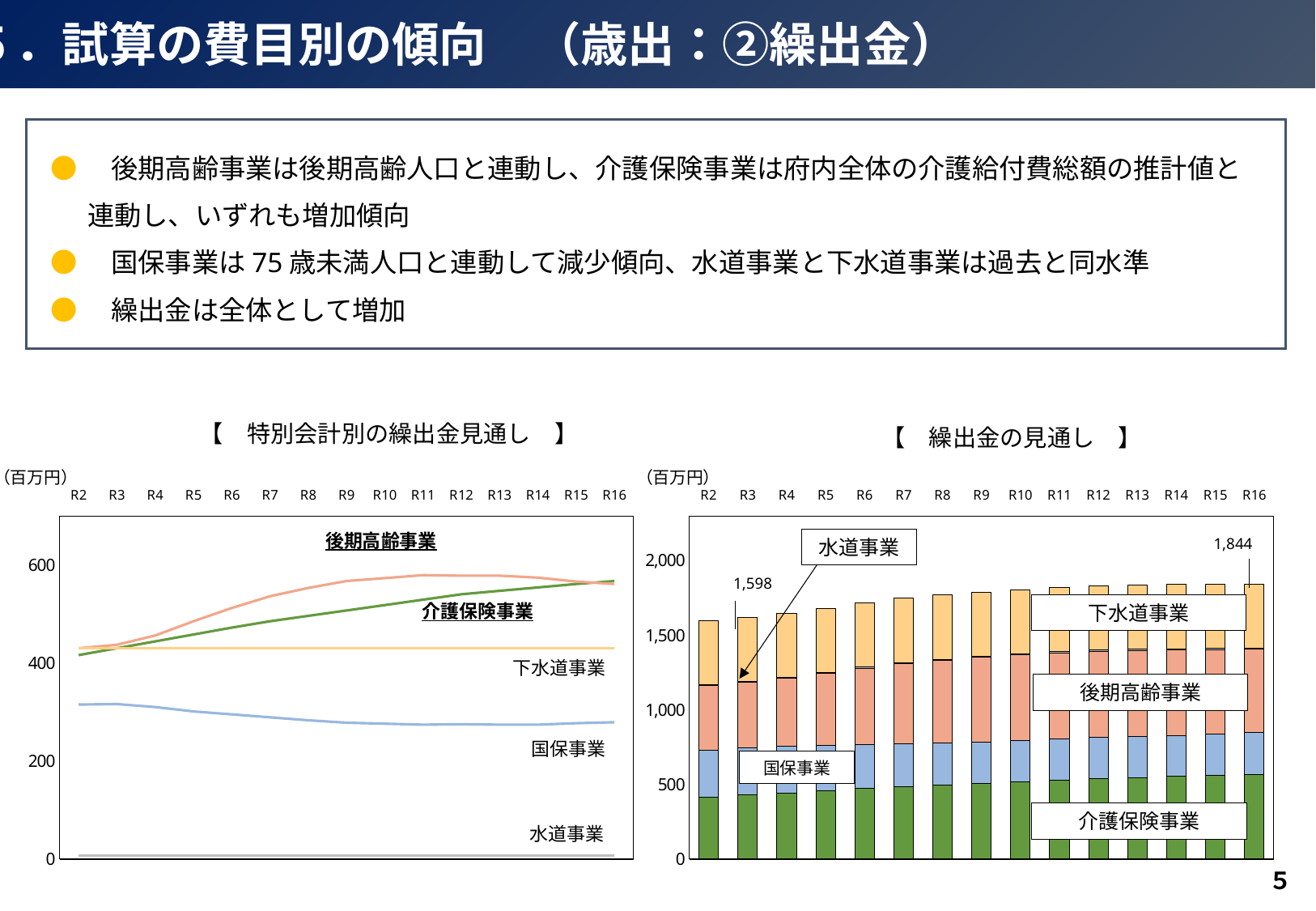
In the left chart (特別会計別の繰出金見通し), does the 国保事業 line rise or fall from R2 to R16? Falls How many series are plotted in the left chart (特別会計別の繰出金見通し)? 5 In the left chart (特別会計別の繰出金見通し), which series has the lowest values? 水道事業 In the right chart (繰出金の見通し), which labelled total is larger, R3 or R16? R16 What kind of chart is the right chart (繰出金の見通し)? Stacked bar chart In the left chart (特別会計別の繰出金見通し), does the 介護保険事業 line rise or fall from R2 to R16? Rises How many years are shown on the x axis of the left chart (特別会計別の繰出金見通し)? 15 In the right chart (繰出金の見通し), what is the total value labelled for R16? 1,844 What kind of chart is the left chart (特別会計別の繰出金見通し)? Line chart In the left chart (特別会計別の繰出金見通し), is the value for 国保事業 at R2 greater or less than 400? less